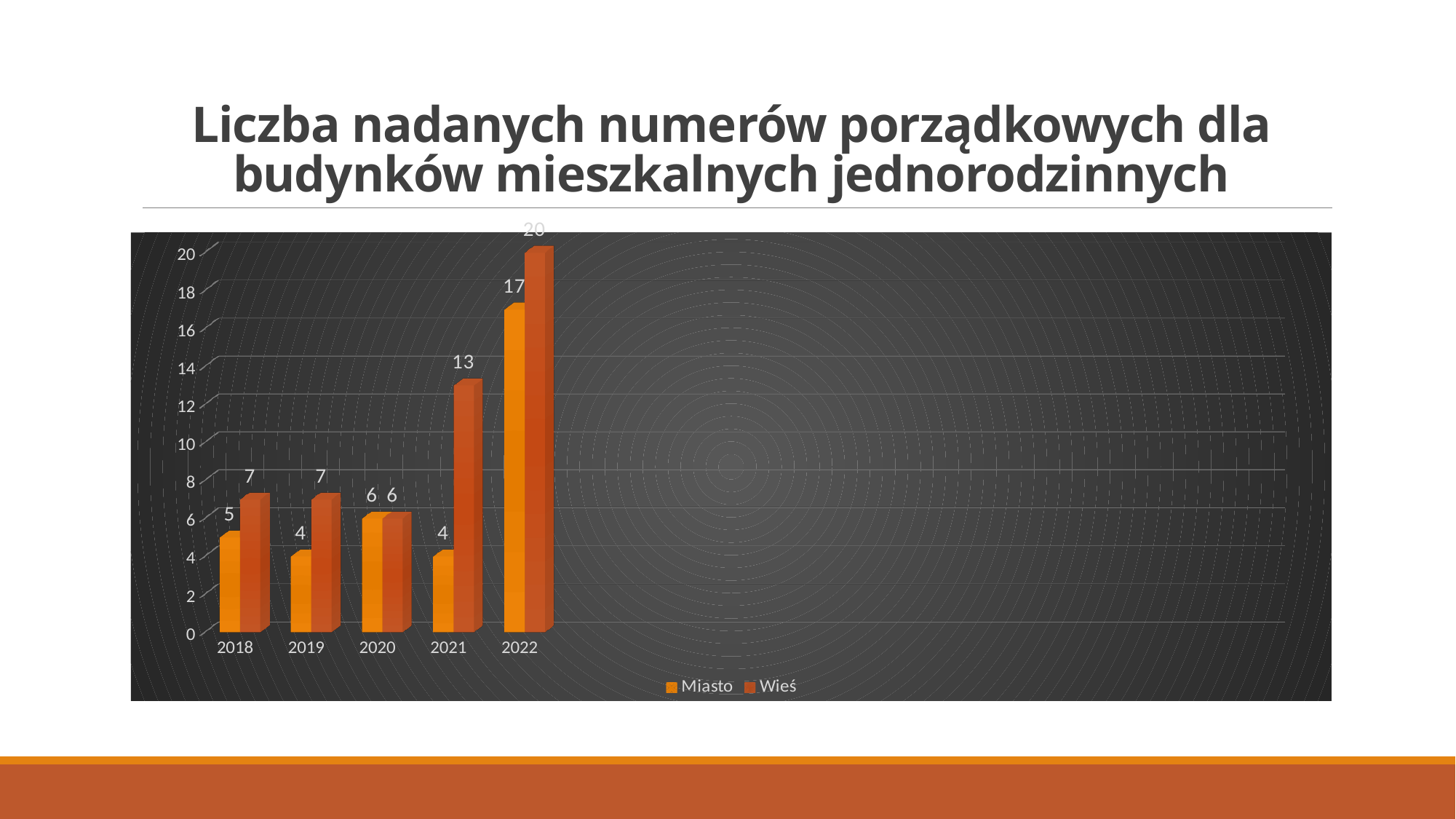
Which year has the lowest value for Wieś? 2020 Which year has the highest value for Wieś? 2022 What is the value for Wieś in 2021? 13 How many years are shown on the x axis? 5 What is the difference between Wieś and Miasto in 2021? 9 What is the value for Miasto in 2018? 5 What kind of chart is shown on the slide? bar chart What are the two series named in the legend? Miasto and Wieś Does the value for Wieś rise or fall from 2020 to 2022? rise How many series does the legend list? 2 What is the value for Miasto in 2022? 17 Which is larger in 2019, Miasto or Wieś? Wieś